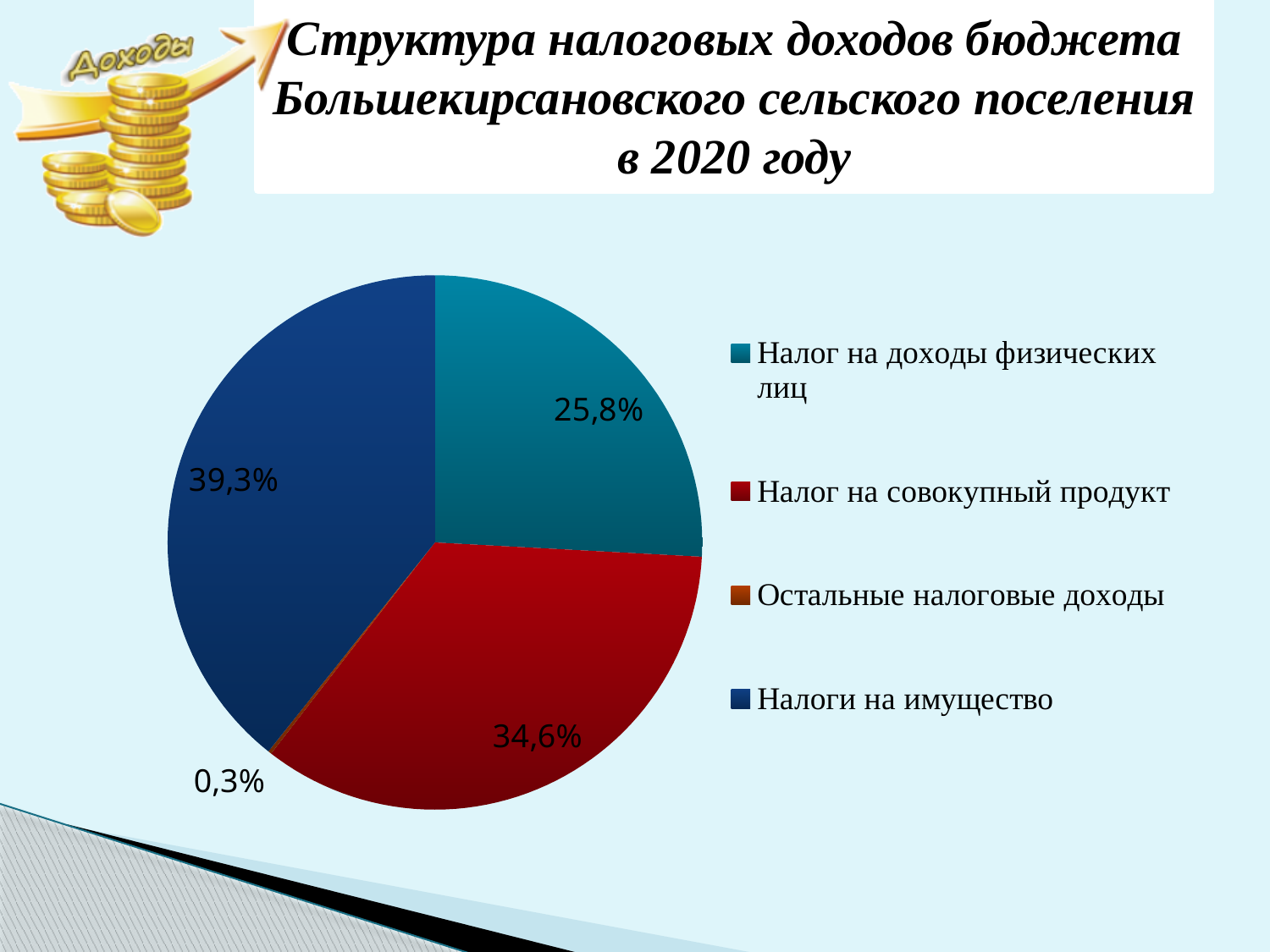
Which is larger: the share of "Налог на совокупный продукт" or the share of "Налог на доходы физических лиц"? Налог на совокупный продукт What share of tax revenues does "Налоги на имущество" account for? 39,3% What share of tax revenues does "Налог на совокупный продукт" account for? 34,6% How many categories does the pie chart show? 4 What share of tax revenues does "Налог на доходы физических лиц" account for? 25,8% What kind of chart is shown on the slide? pie chart Which category has the smallest share of the pie? Остальные налоговые доходы What share of tax revenues does "Остальные налоговые доходы" account for? 0,3% Which category has the largest share of the pie? Налоги на имущество What is the difference in percentage points between "Налоги на имущество" and "Налог на совокупный продукт"? 4,7 What colour is the slice for "Налог на совокупный продукт"? red What is the difference in percentage points between "Налоги на имущество" and "Налог на доходы физических лиц"? 13,5